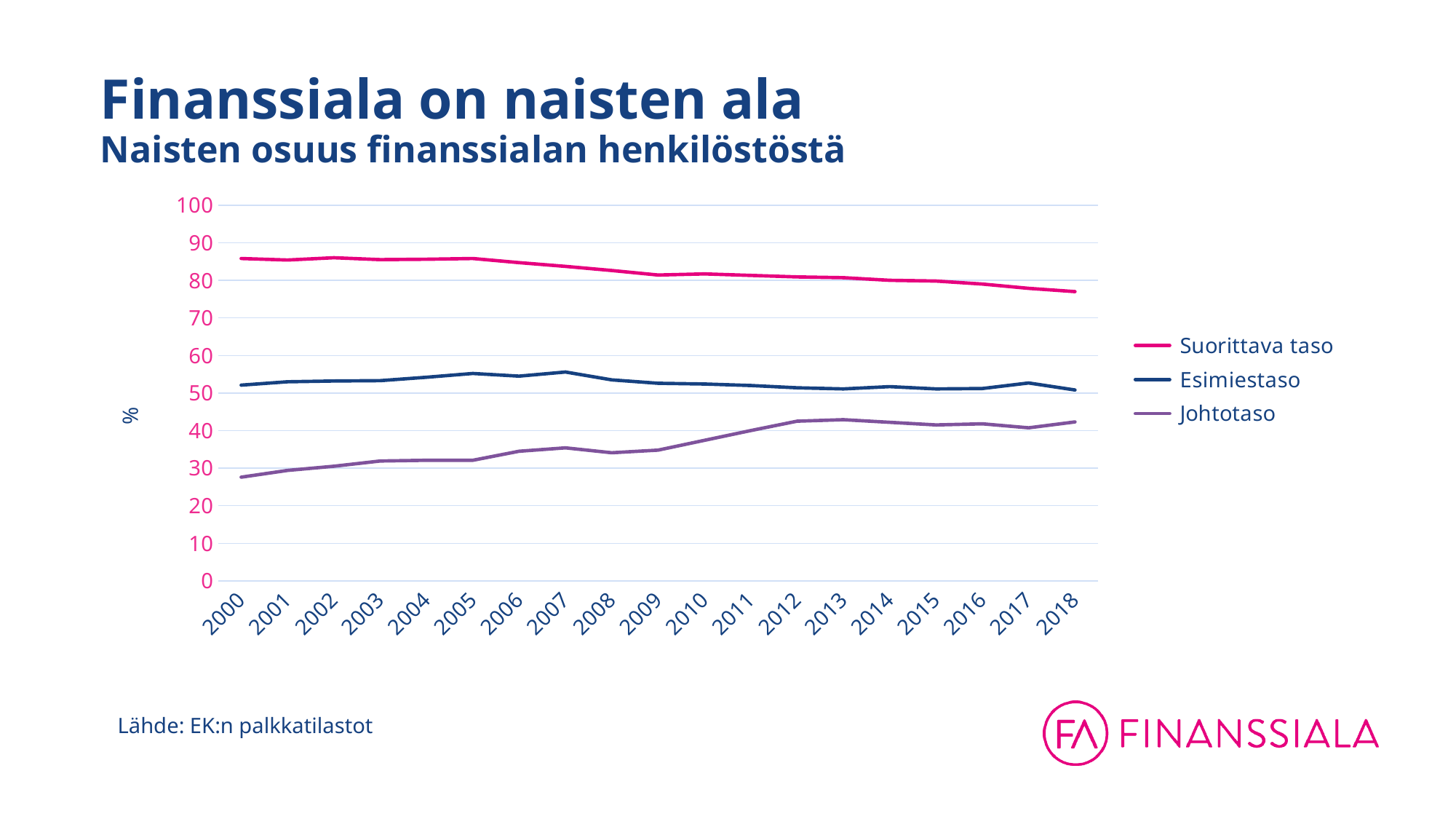
Is the value for Suorittava taso in 2018 greater or less than 80? less What kind of chart is shown on the slide? line chart Does the Suorittava taso line rise or fall from 2000 to 2018? fall How many years are shown on the x axis? 19 Is the value for Johtotaso in 2018 greater or less than 40? greater Is the value for Suorittava taso in 2000 greater or less than 80? greater Which series has the lowest value in 2000? Johtotaso How many series does the legend list? 3 Does the Johtotaso line rise or fall from 2000 to 2018? rise What is the label on the y axis? % Which series has the highest values across all years? Suorittava taso